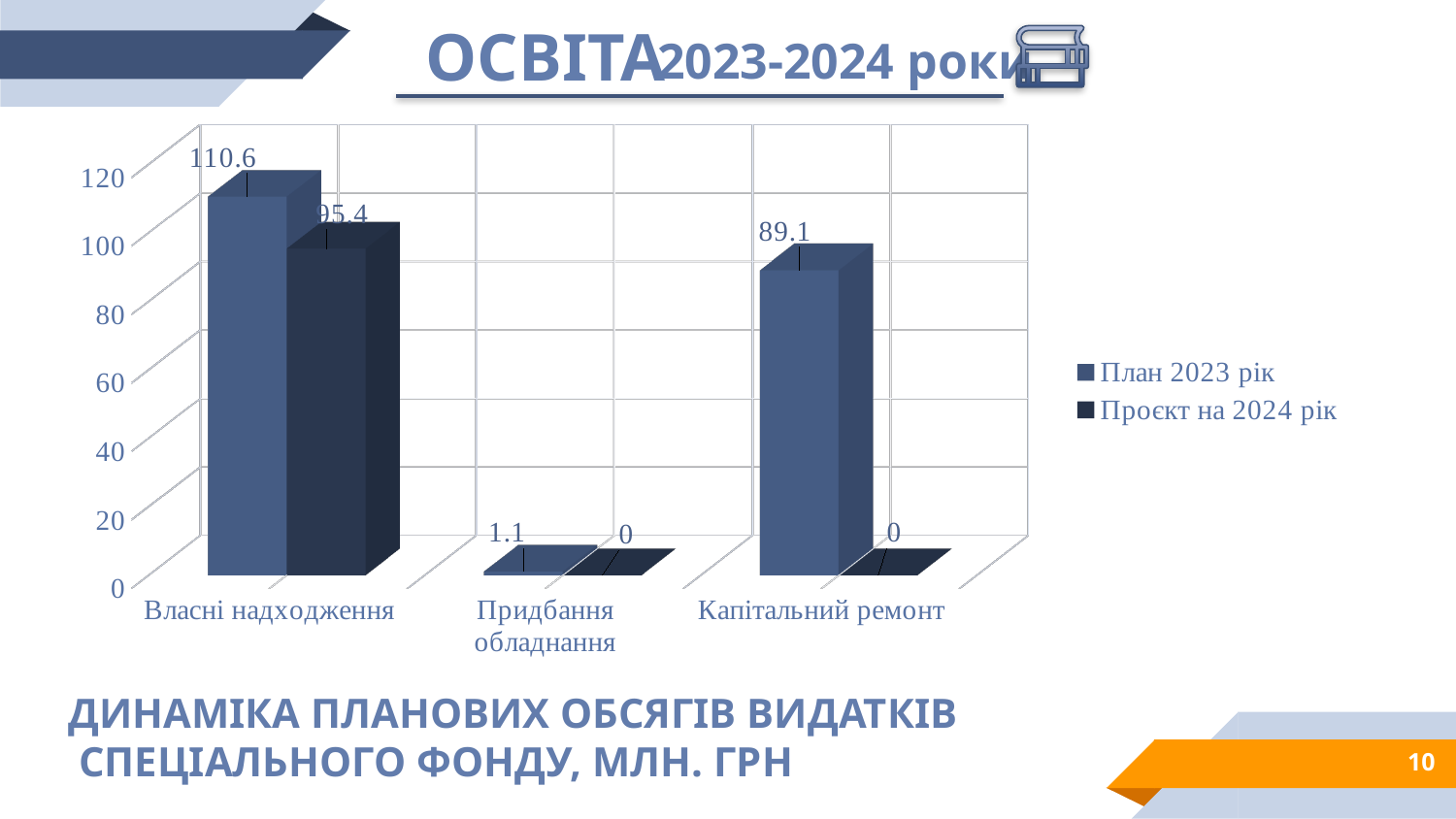
How many series does the legend list? 2 Which category has the lowest value in the План 2023 рік series? Придбання обладнання What is the value for Капітальний ремонт in the Проєкт на 2024 рік series? 0 What is the value for Придбання обладнання in the План 2023 рік series? 1.1 What is the value for Капітальний ремонт in the План 2023 рік series? 89.1 What is the value for Власні надходження in the Проєкт на 2024 рік series? 95.4 Which is larger: the План 2023 рік value for Власні надходження or for Капітальний ремонт? Власні надходження Which category has the highest value in the План 2023 рік series? Власні надходження What is the difference between the План 2023 рік and Проєкт на 2024 рік values for Власні надходження? 15.2 What kind of chart is shown on the slide? Bar chart How many categories are shown on the x axis? 3 What is the value for Власні надходження in the План 2023 рік series? 110.6